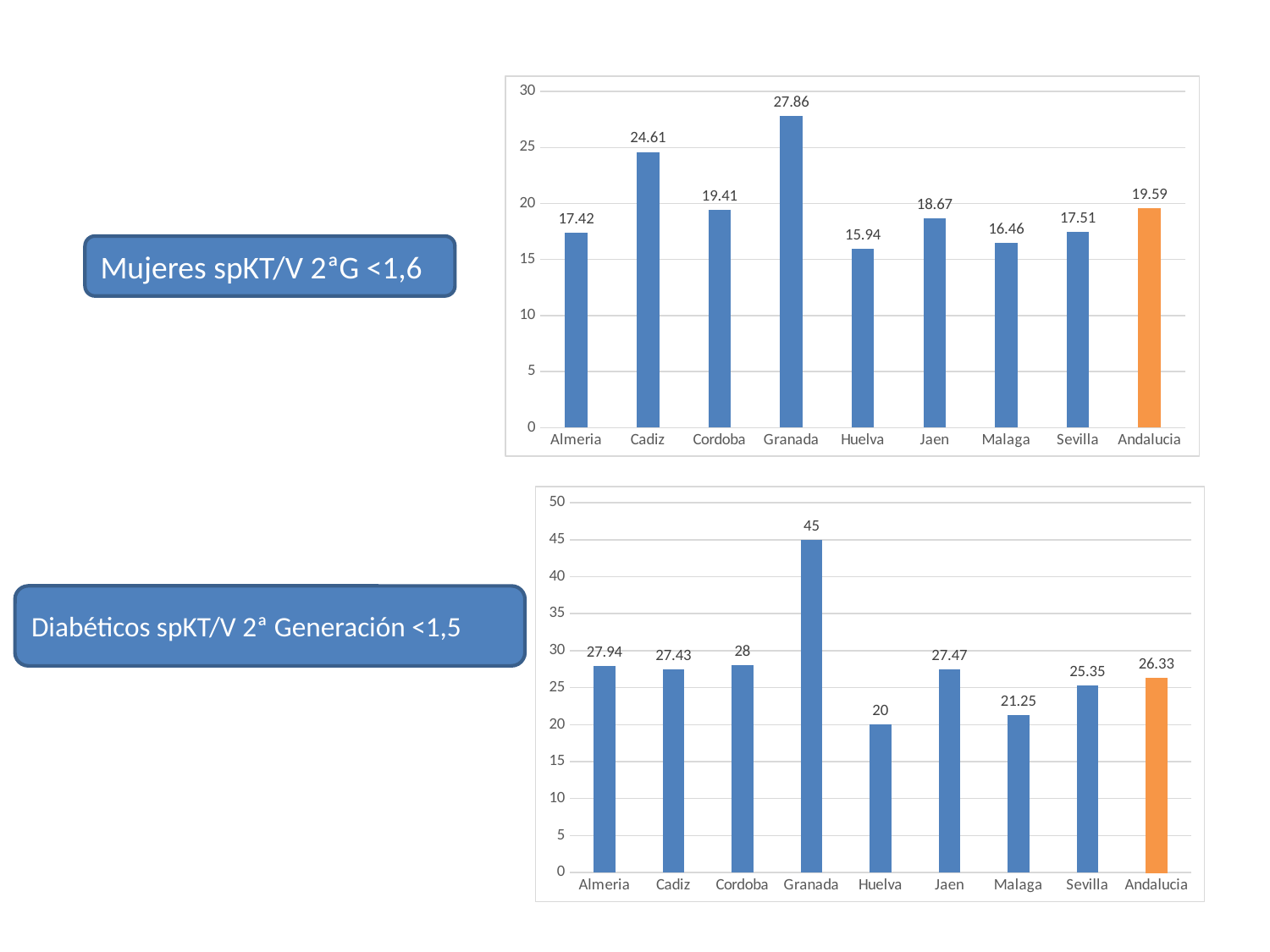
In the top chart (Mujeres spKT/V 2ªG <1,6), what is the value for Granada? 27.86 In the top chart (Mujeres spKT/V 2ªG <1,6), what is the difference between Cadiz and Almeria? 7.19 In the bottom chart (Diabéticos spKT/V 2ª Generación <1,5), which category has the highest value? Granada In the top chart (Mujeres spKT/V 2ªG <1,6), what is the value for Andalucia? 19.59 In the bottom chart (Diabéticos spKT/V 2ª Generación <1,5), which is larger, Sevilla or Malaga? Sevilla What kind of chart is the top chart (Mujeres spKT/V 2ªG <1,6)? Bar chart In the top chart (Mujeres spKT/V 2ªG <1,6), how many categories are shown on the x axis? 9 In the bottom chart (Diabéticos spKT/V 2ª Generación <1,5), is the value for Cordoba greater or less than 25? greater In the bottom chart (Diabéticos spKT/V 2ª Generación <1,5), what is the difference between Granada and Andalucia? 18.67 In the bottom chart (Diabéticos spKT/V 2ª Generación <1,5), what is the value for Huelva? 20 In the bottom chart (Diabéticos spKT/V 2ª Generación <1,5), which bar is coloured orange? Andalucia In the top chart (Mujeres spKT/V 2ªG <1,6), which category has the lowest value? Huelva